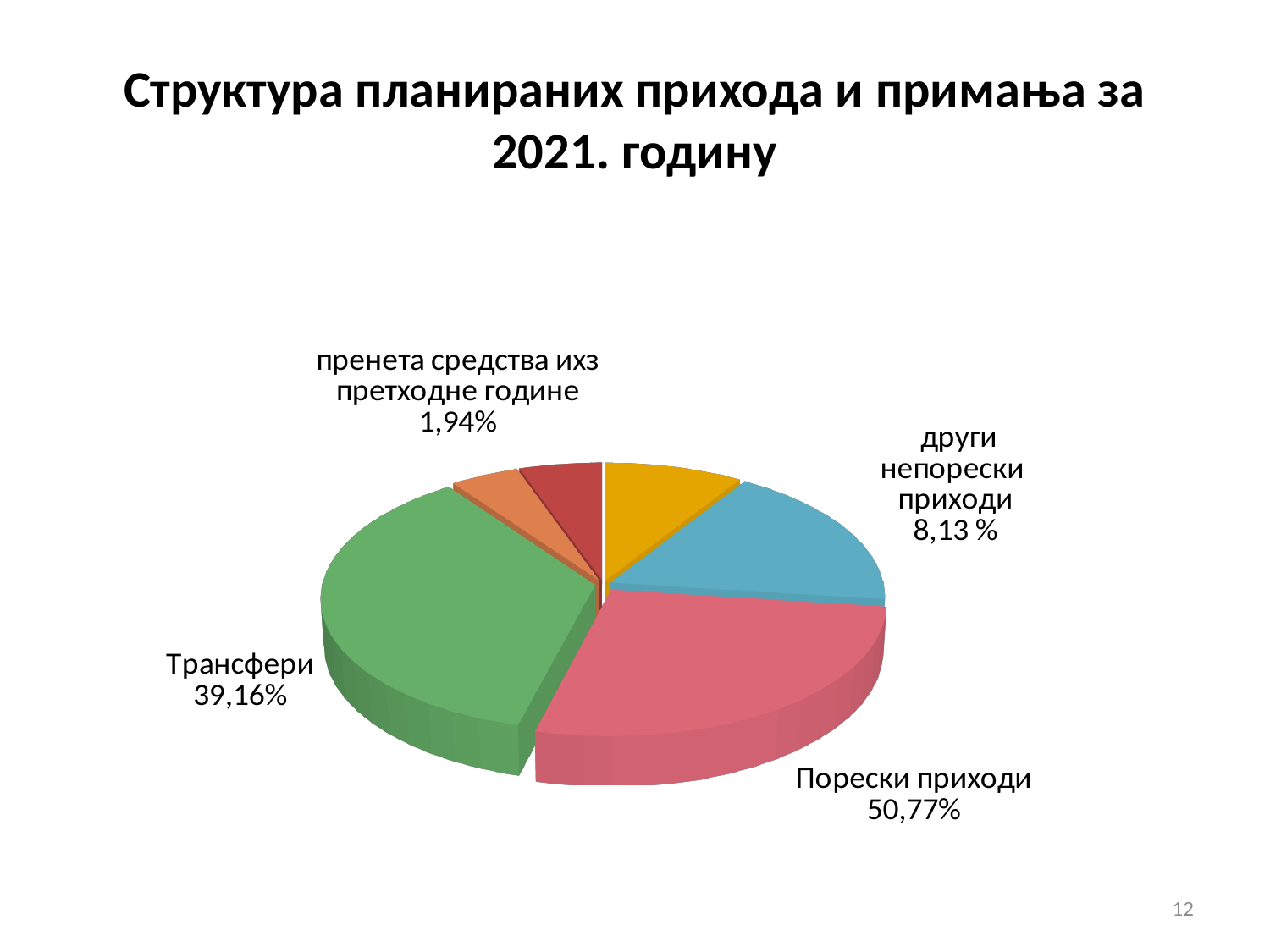
What share of the pie is labelled for други непорески приходи? 8,13 % What is the difference in percentage points between the shares for други непорески приходи and пренета средства ихз претходне године? 6,19 Which labelled category has the largest share of the pie? Порески приходи Which is larger, the share for други непорески приходи or the share for пренета средства ихз претходне године? други непорески приходи What share of the pie is labelled for пренета средства ихз претходне године? 1,94% What is the title of the slide containing the pie chart? Структура планираних прихода и примања за 2021. годину What share of the pie is labelled for Порески приходи? 50,77% What kind of chart is shown on the slide? pie chart What is the difference in percentage points between the shares for Порески приходи and Трансфери? 11,61 What share of the pie is labelled for Трансфери? 39,16% Which is larger, the share for Трансфери or the share for Порески приходи? Порески приходи Is the share for Трансфери greater or less than 40%? less